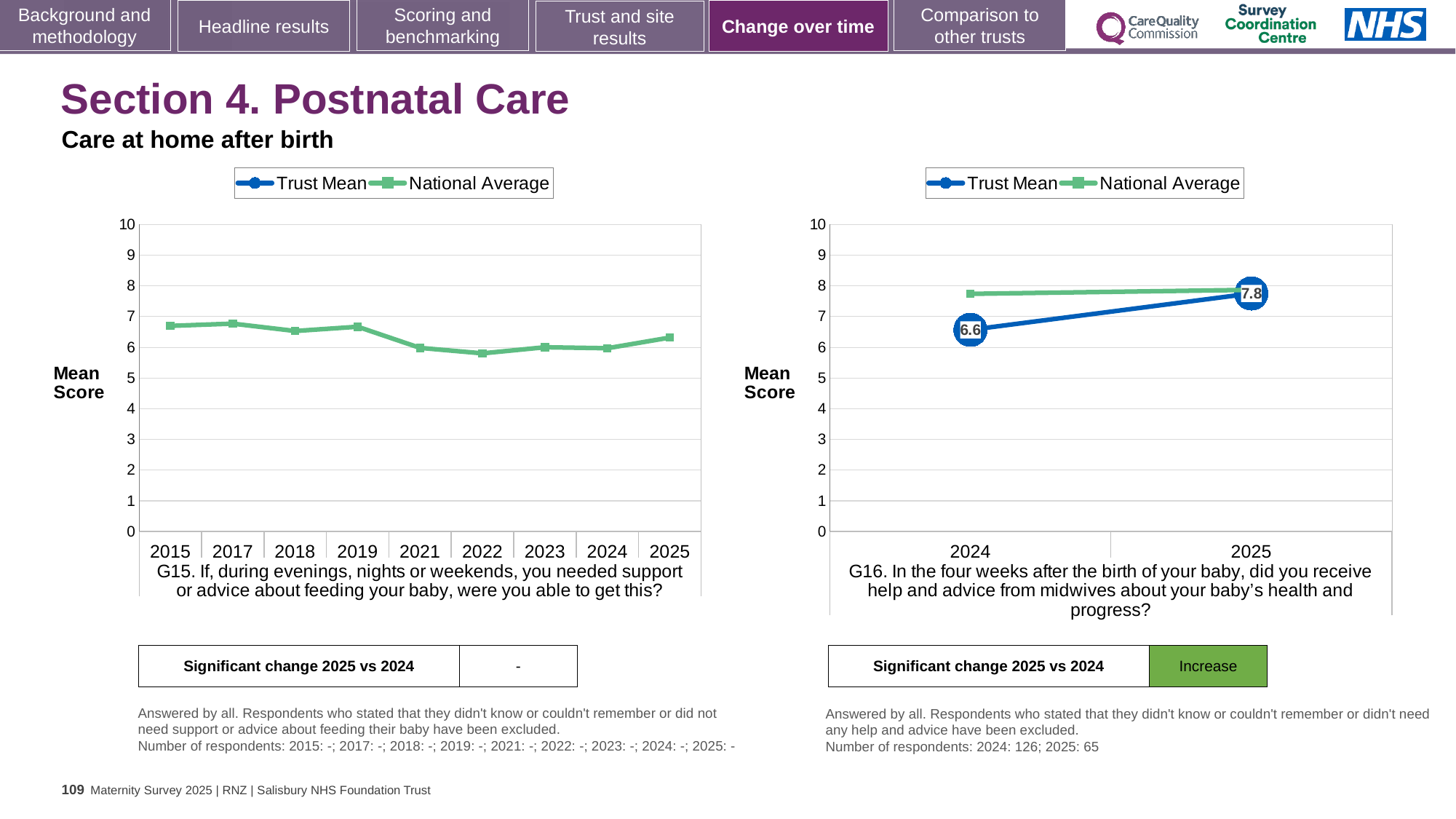
On the right chart (G16), how many years are shown on the x axis? 2 On the right chart (G16), is the National Average value for 2024 greater or less than 7? greater On the right chart (G16), does the Trust Mean rise or fall from 2024 to 2025? rise On the right chart (G16), what is the Trust Mean score for 2024? 6.6 What kind of chart is the left chart (G15)? line chart On the right chart (G16), which year has the higher Trust Mean, 2024 or 2025? 2025 On the right chart (G16), by how much did the Trust Mean change from 2024 to 2025? 1.2 On the left chart (G15), how many series does the legend list? 2 On the left chart (G15), is the National Average value for 2015 greater or less than 6? greater On the left chart (G15), how many years are shown on the x axis? 9 On the right chart (G16), what does the 'Significant change 2025 vs 2024' box below the chart say? Increase On the right chart (G16), what is the Trust Mean score for 2025? 7.8